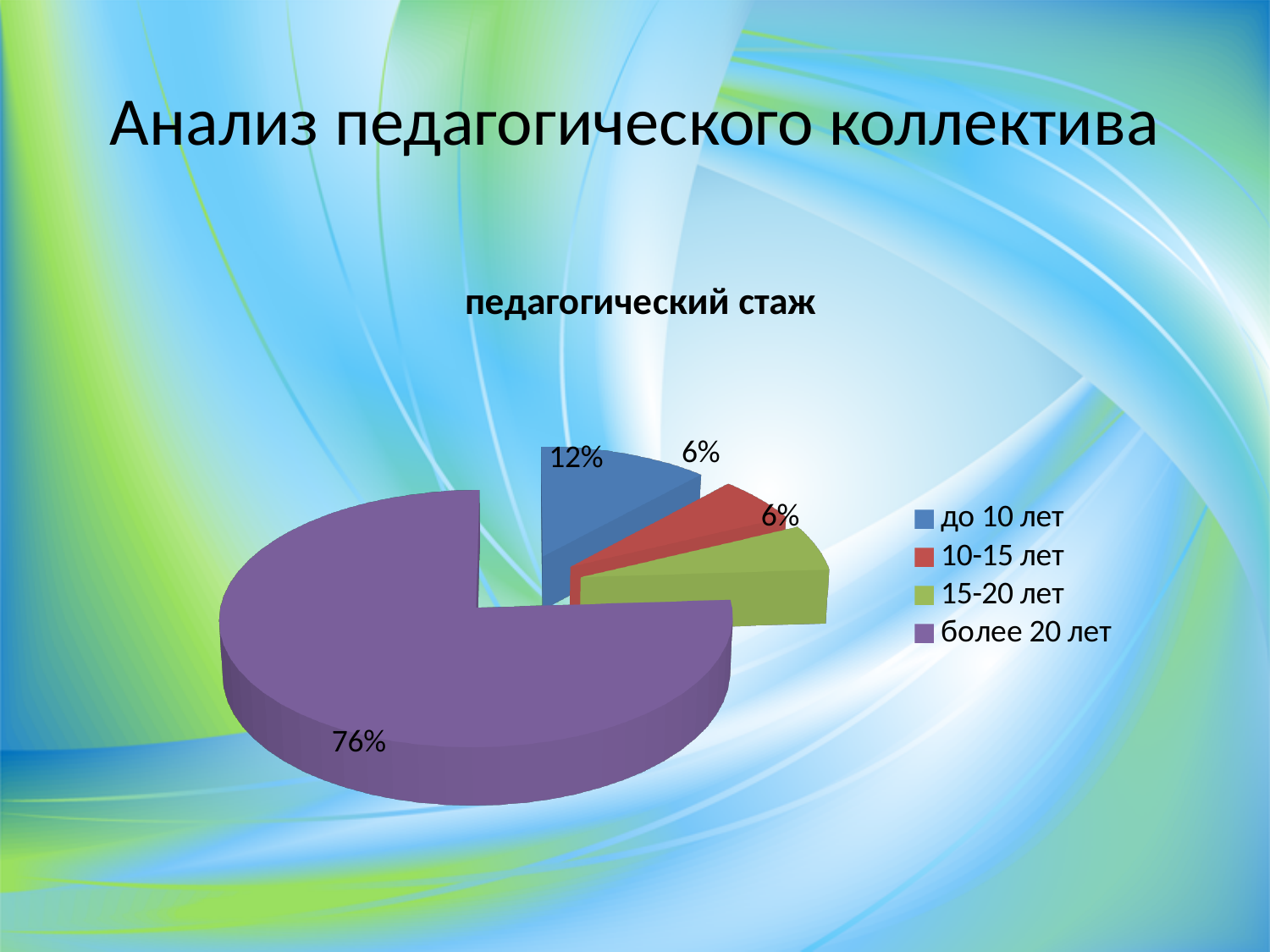
What is the difference in percentage points between the share for "более 20 лет" and the share for "до 10 лет"? 64 Which is larger, the share for "до 10 лет" or the share for "10-15 лет"? до 10 лет Which category has the largest share of the pie? более 20 лет Which colour represents the category "более 20 лет" in the chart? purple What share of the pie does the category "более 20 лет" have? 76% What is the value shown for "10-15 лет"? 6% How many categories does the legend of the chart list? 4 What is the title of the chart? педагогический стаж How many slices does the pie chart have? 4 What kind of chart is shown on the slide? pie chart What is the value shown for "до 10 лет"? 12% What is the value shown for "15-20 лет"? 6%